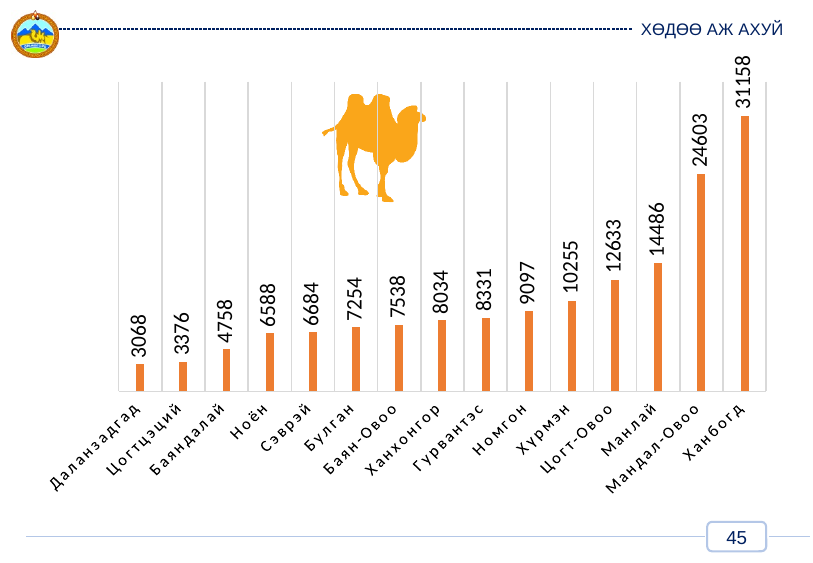
How many categories are shown in the chart? 15 What is the value shown for Даланзадгад? 3068 What is the value shown for Ханбогд? 31158 Which has a larger value, Гурвантэс or Номгон? Номгон Which category has the highest value? Ханбогд Do the values rise or fall from left to right across the categories? Rise Which category has the lowest value? Даланзадгад What is the value shown for Хүрмэн? 10255 What type of chart is shown on the slide? Bar chart What is the value shown for Мандал-Овоо? 24603 What is the difference between the values for Ханбогд and Мандал-Овоо? 6555 What is the difference between the values for Манлай and Цогт-Овоо? 1853